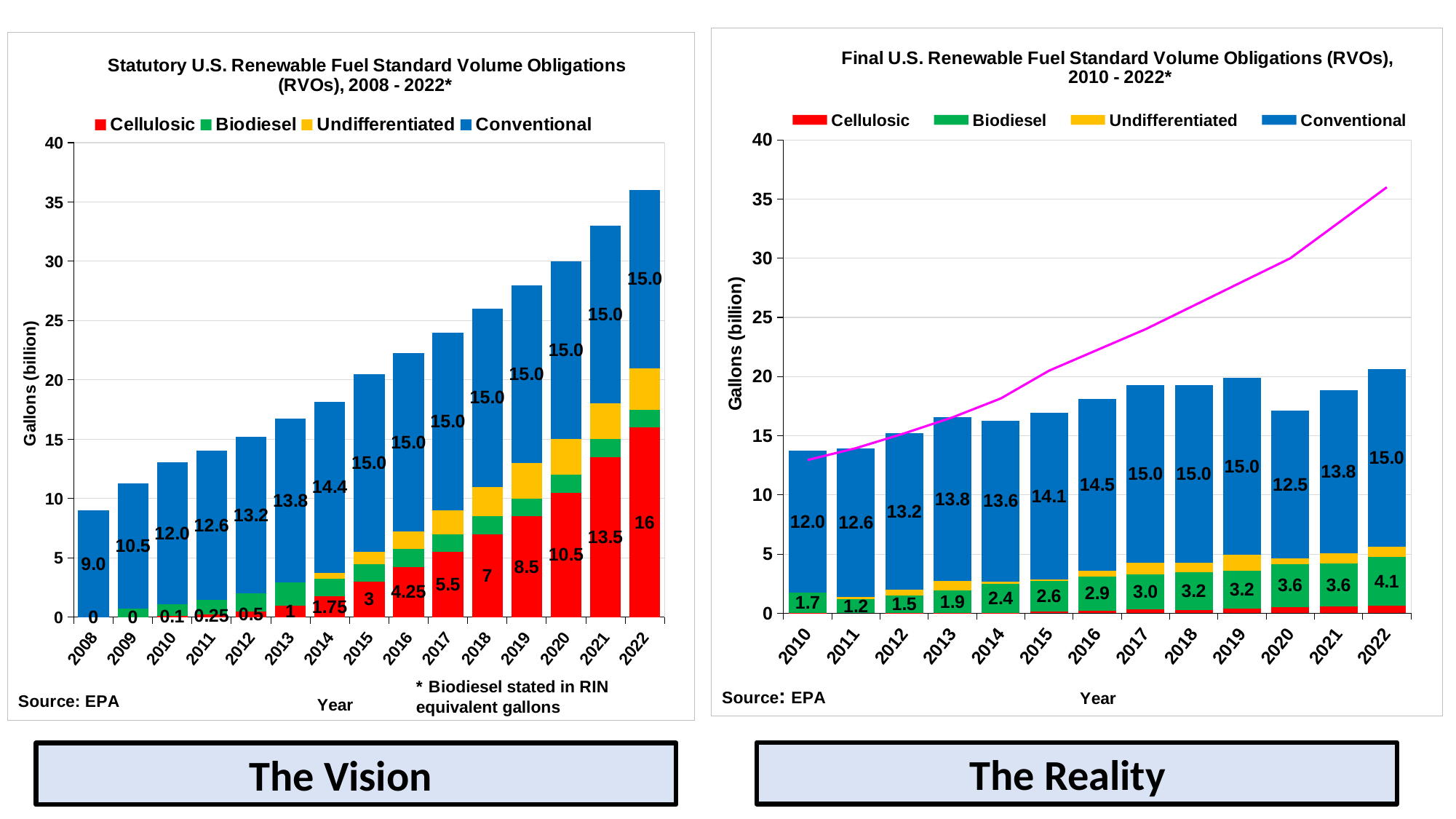
In the left chart (Statutory RVOs), how many series does the legend list? 4 In the right chart (Final RVOs), is the total stacked value for 2015 greater or less than 20? less In the right chart (Final RVOs), which year has the highest Biodiesel value? 2022 In the right chart (Final RVOs), is the Biodiesel value larger in 2014 or 2015? 2015 What kind of chart is the left chart (Statutory RVOs)? Stacked bar chart In the left chart (Statutory RVOs), how many years are shown on the x axis? 15 In the left chart (Statutory RVOs), what is the Conventional value for 2012? 13.2 In the left chart (Statutory RVOs), do the Cellulosic values rise or fall from 2008 to 2022? Rise In the right chart (Final RVOs), which year has the lowest Conventional value? 2010 In the left chart (Statutory RVOs), what is the difference between the Cellulosic values for 2022 and 2021? 2.5 In the left chart (Statutory RVOs), what is the Cellulosic value for 2020? 10.5 In the right chart (Final RVOs), what is the Conventional value for 2020? 12.5